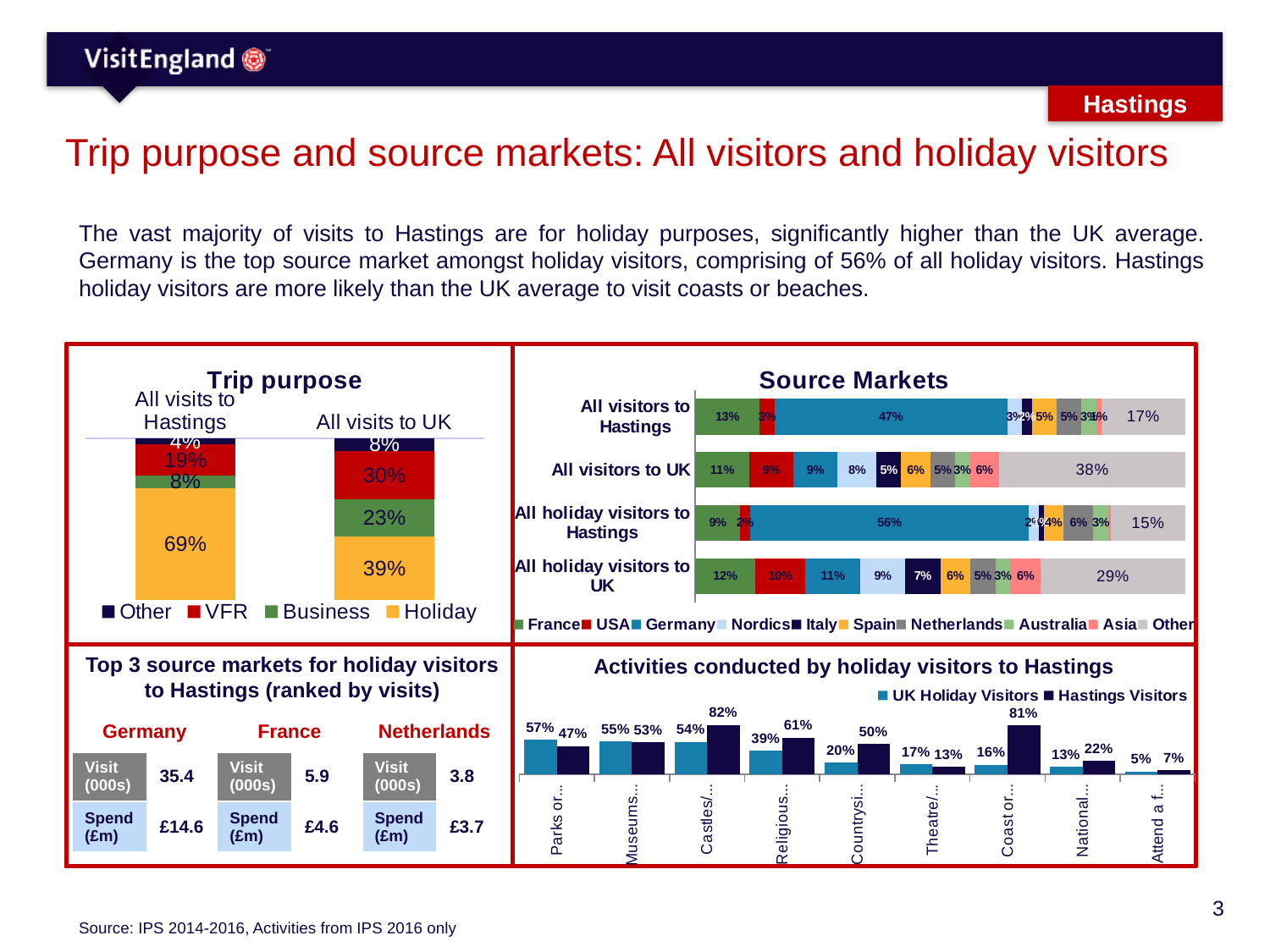
What kind of chart is the Activities conducted by holiday visitors to Hastings chart? Bar chart In the Trip purpose chart, what share of all visits to UK are for VFR? 30% How many series does the legend of the Trip purpose chart list? 4 In the Source Markets chart, which is larger: the France share of all visitors to Hastings or the France share of all visitors to UK? All visitors to Hastings In the Source Markets chart, what share of all holiday visitors to Hastings come from Germany? 56% In the Activities conducted by holiday visitors to Hastings chart, what is the difference between Hastings Visitors and UK Holiday Visitors for the Countrysi... category? 30 percentage points How many series does the legend of the Source Markets chart list? 10 In the Activities conducted by holiday visitors to Hastings chart, what is the value for Hastings Visitors for the Coast or... category? 81% In the Activities conducted by holiday visitors to Hastings chart, which category has the highest value for Hastings Visitors? Castles/... In the Trip purpose chart, what is the difference between the Holiday share for all visits to Hastings and for all visits to UK? 39 percentage points In the Source Markets chart, what share of all visitors to UK fall in the Other category? 38% In the Trip purpose chart, what share of all visits to Hastings are for Holiday? 69%